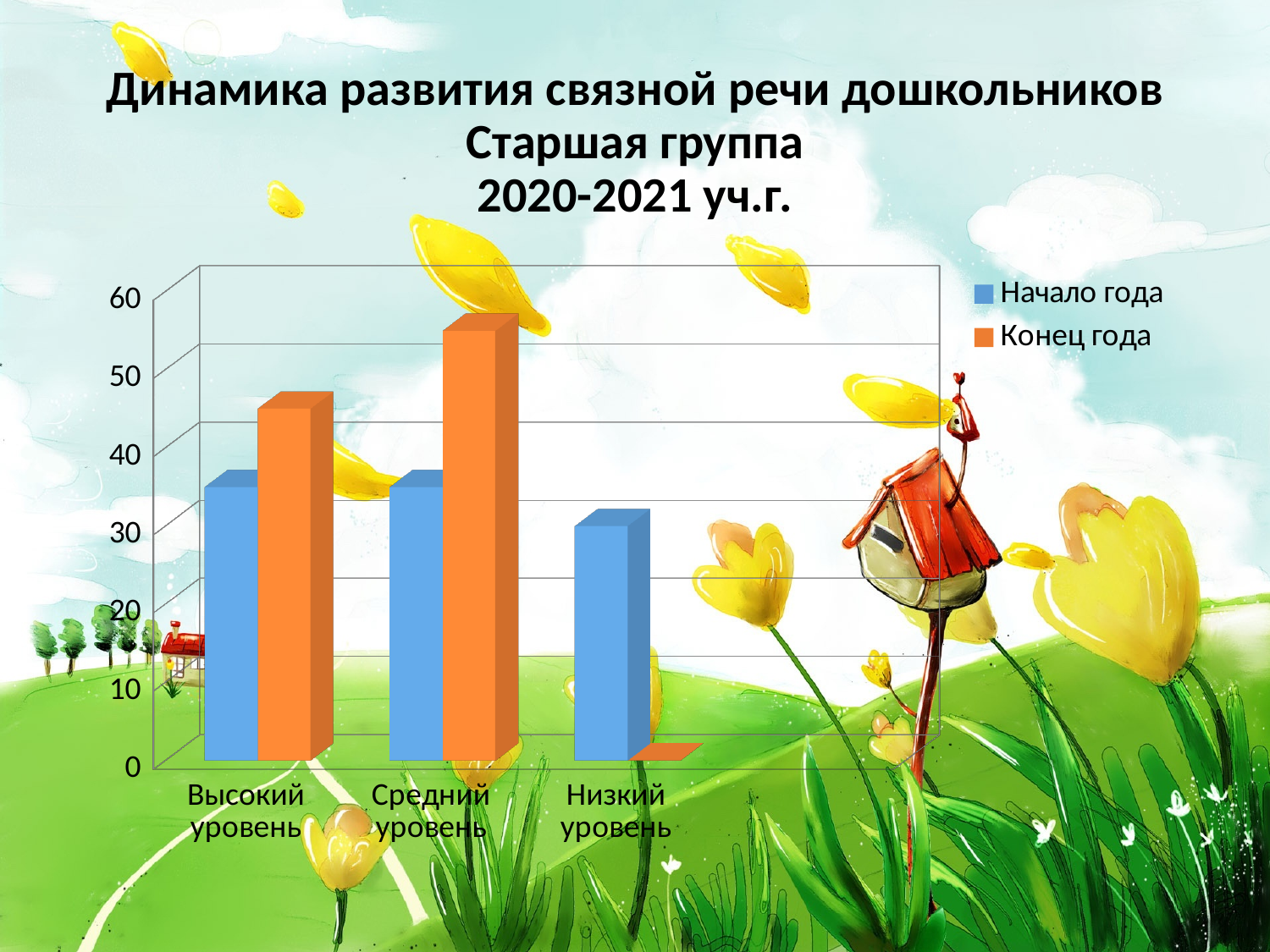
Which category has the lowest value for the series Конец года? Низкий уровень Is the value for Конец года in the category Средний уровень greater or less than 50? greater Which category has the lowest value for the series Начало года? Низкий уровень In the category Средний уровень, which series has the larger value, Начало года or Конец года? Конец года Which category has the highest value for the series Конец года? Средний уровень What kind of chart is shown on the slide? bar chart Is the value for Конец года in the category Высокий уровень greater or less than 40? greater Is the value for Конец года in the category Низкий уровень greater or less than 10? less How many categories are shown on the x axis of the chart? 3 Which series is shown in orange in the chart legend? Конец года How many series does the chart legend list? 2